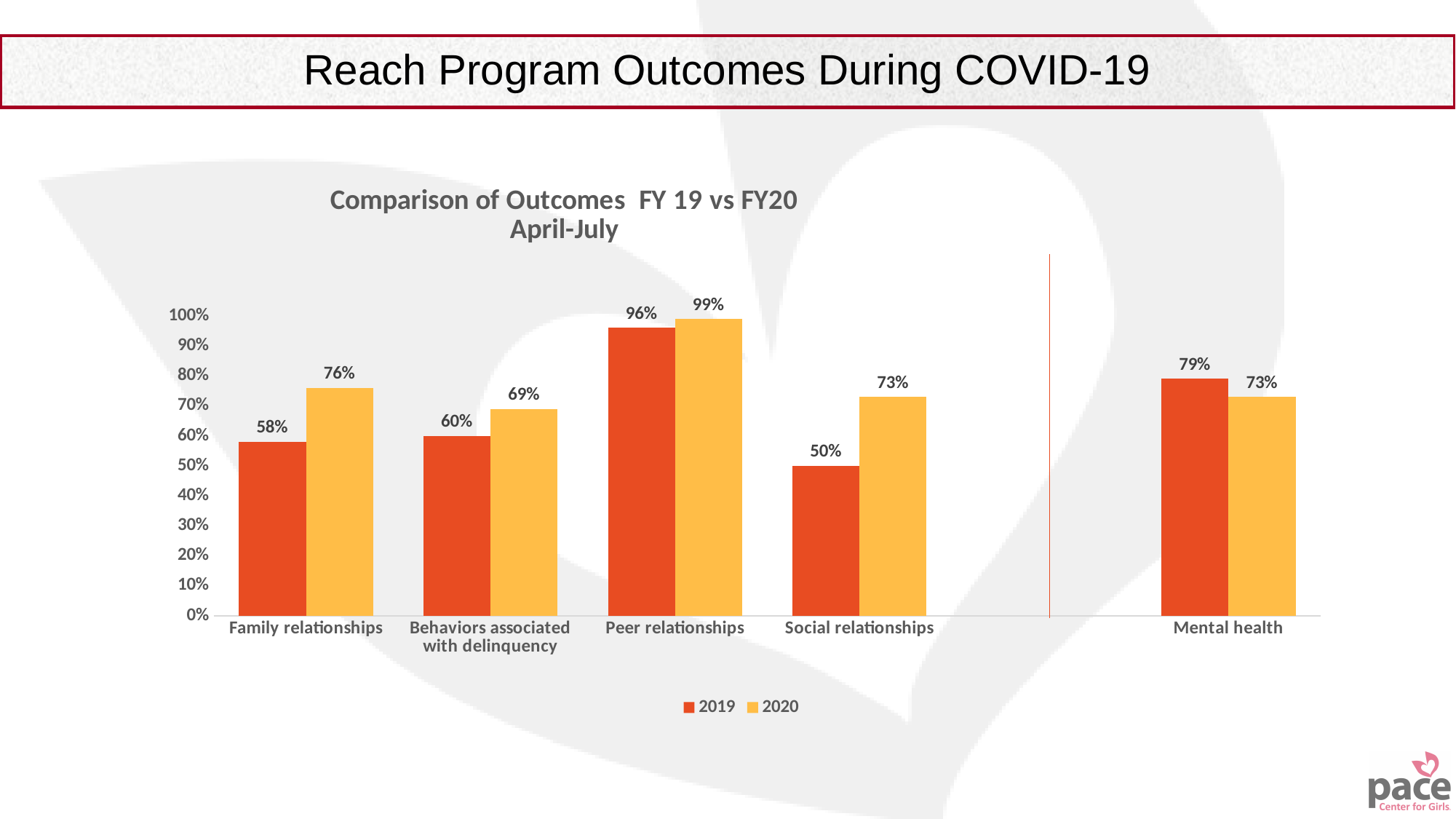
What is the difference between the 2020 and 2019 values for Social relationships? 23% Which category has the lowest 2019 value? Social relationships What is the title of the chart? Comparison of Outcomes FY 19 vs FY20 April-July What is the 2020 value for Family relationships? 76% What kind of chart is shown on the slide? Bar chart How many categories are shown on the x axis? 5 How many series does the legend list? 2 Is the 2019 value for Behaviors associated with delinquency greater or less than 50%? greater What is the 2019 value for Social relationships? 50% Which category has the highest 2020 value? Peer relationships What is the 2019 value for Mental health? 79% For Mental health, which series has the larger value, 2019 or 2020? 2019